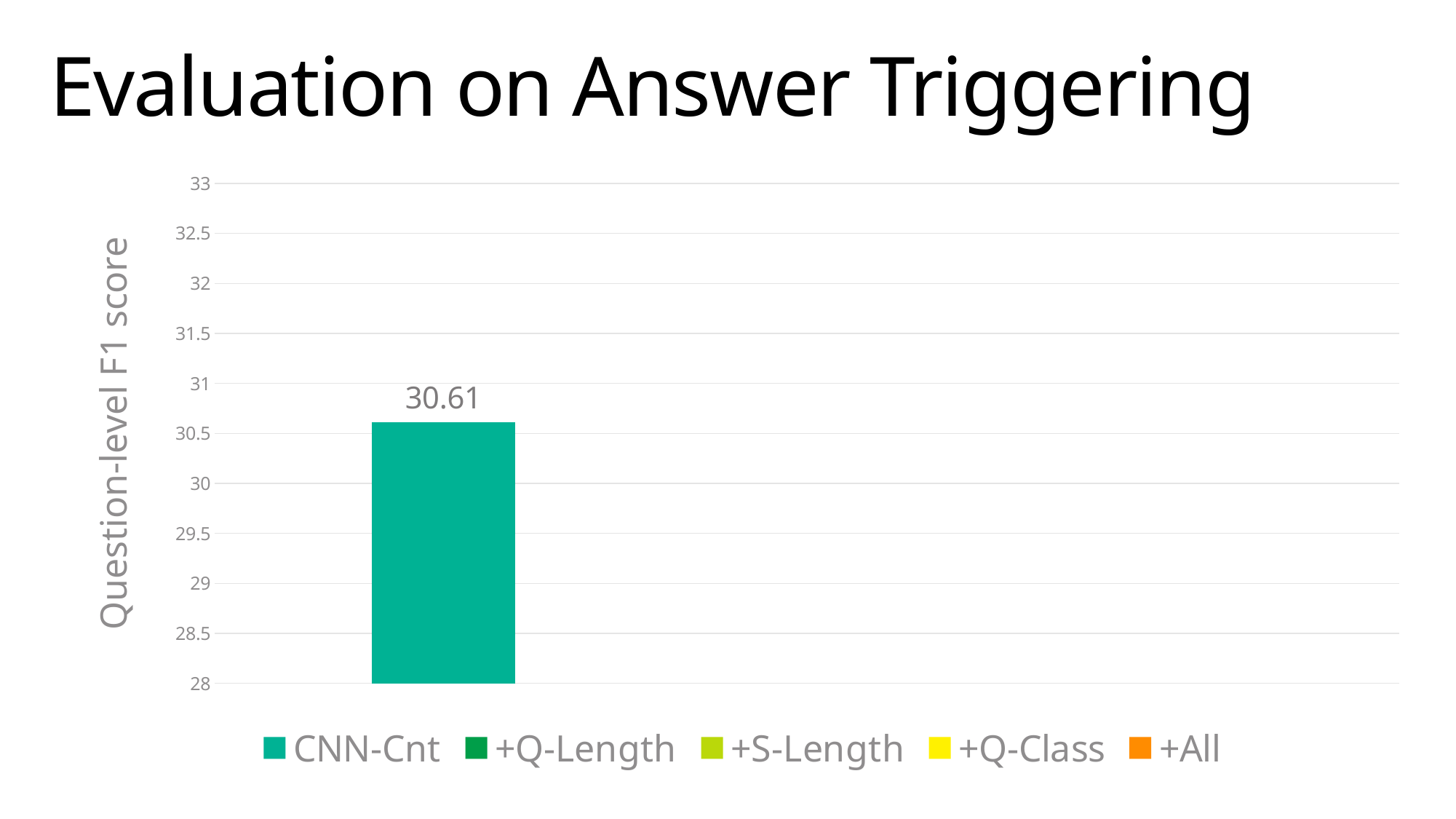
What is the Question-level F1 score shown for CNN-Cnt? 30.61 Which series is the only one with a bar plotted in the chart? CNN-Cnt What is the highest value shown on the vertical axis? 33 What kind of chart is shown on the slide? bar chart Is the value for CNN-Cnt greater or less than 30? greater What is the title of the slide containing the chart? Evaluation on Answer Triggering Is the value for CNN-Cnt greater or less than 31? less What is the label of the vertical axis? Question-level F1 score What is the lowest value shown on the vertical axis? 28 How many series does the legend list? 5 How many bars are actually plotted in the chart? 1